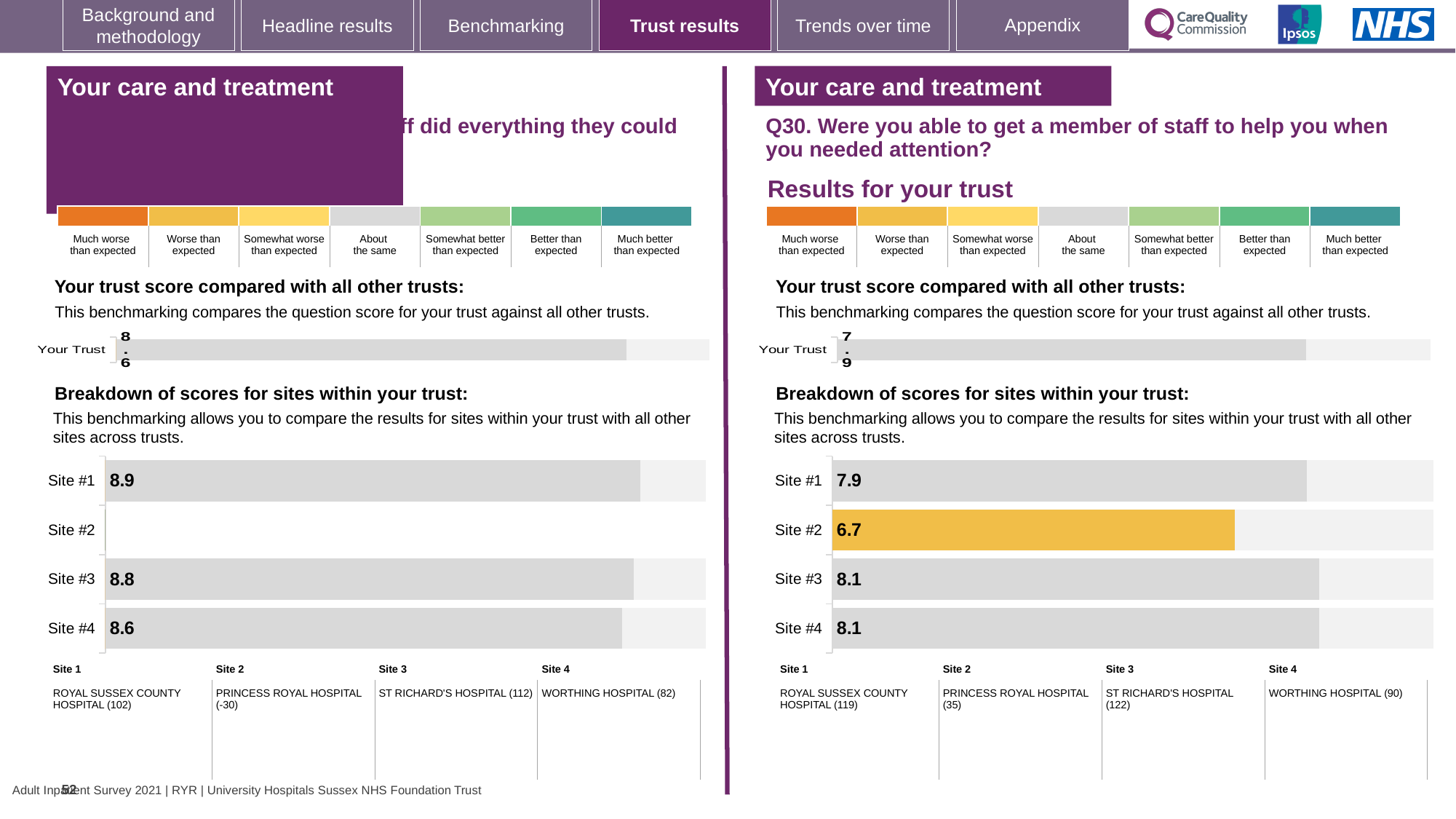
On the left-hand site breakdown chart, what is the score for Site #1? 8.9 On the right-hand chart (Q30), what is the score for Site #1? 7.9 On the right-hand chart (Q30), which site's bar is coloured yellow rather than grey? Site #2 What kind of chart is used for the breakdown of scores for sites within the trust on the right-hand side? Bar chart On the right-hand chart (Q30), what is the difference between the scores for Site #3 and Site #2? 1.4 On the right-hand chart (Q30), what is the score for Site #2? 6.7 On the left-hand site breakdown chart, which of Site #1 or Site #3 has the higher score? Site #1 On the left-hand site breakdown chart, what is the difference between the scores for Site #1 and Site #4? 0.3 On the right-hand chart (Q30), which site has the lowest score? Site #2 On the left-hand chart, what is the 'Your Trust' score? 8.6 On the right-hand chart (Q30), what is the 'Your Trust' score? 7.9 On the left-hand site breakdown chart, what is the score for Site #4? 8.6